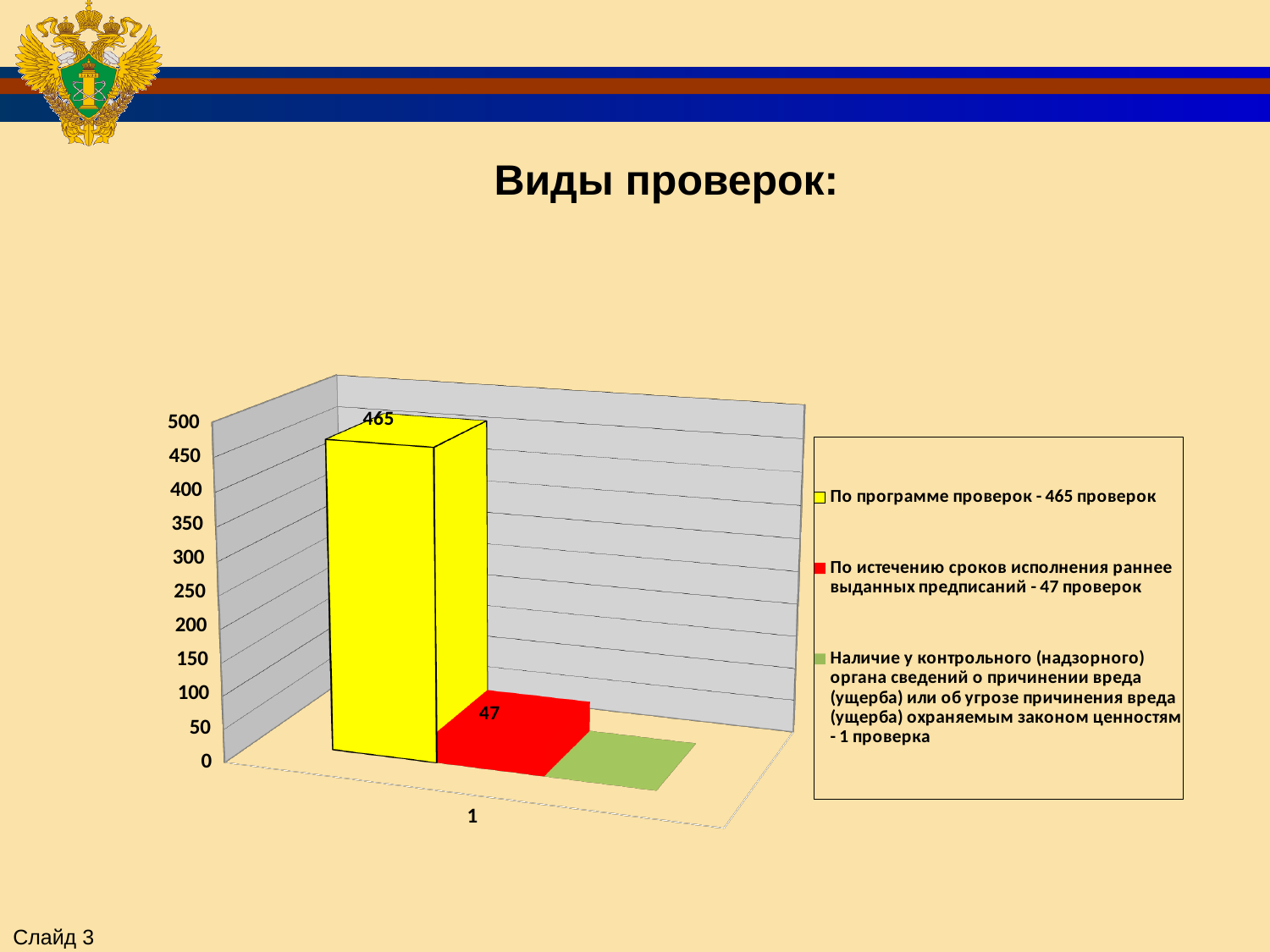
What value is shown for the series 'По истечению сроков исполнения раннее выданных предписаний'? 47 What value is shown for the series 'По программе проверок'? 465 Is the value for 'По истечению сроков исполнения раннее выданных предписаний' greater or less than 100? less According to the legend, how many checks are in the series 'Наличие у контрольного (надзорного) органа сведений о причинении вреда'? 1 Is the value for 'По программе проверок' greater or less than 400? greater Which series has the highest value? По программе проверок Which series has the lowest value? Наличие у контрольного (надзорного) органа сведений о причинении вреда (ущерба) или об угрозе причинения вреда (ущерба) охраняемым законом ценностям What is the difference between the value for 'По программе проверок' and the value for 'По истечению сроков исполнения раннее выданных предписаний'? 418 How many series does the legend list? 3 What colour is the bar for 'По программе проверок'? yellow Which is larger: the value for 'По программе проверок' or the value for 'По истечению сроков исполнения раннее выданных предписаний'? По программе проверок What kind of chart is shown on the slide? bar chart